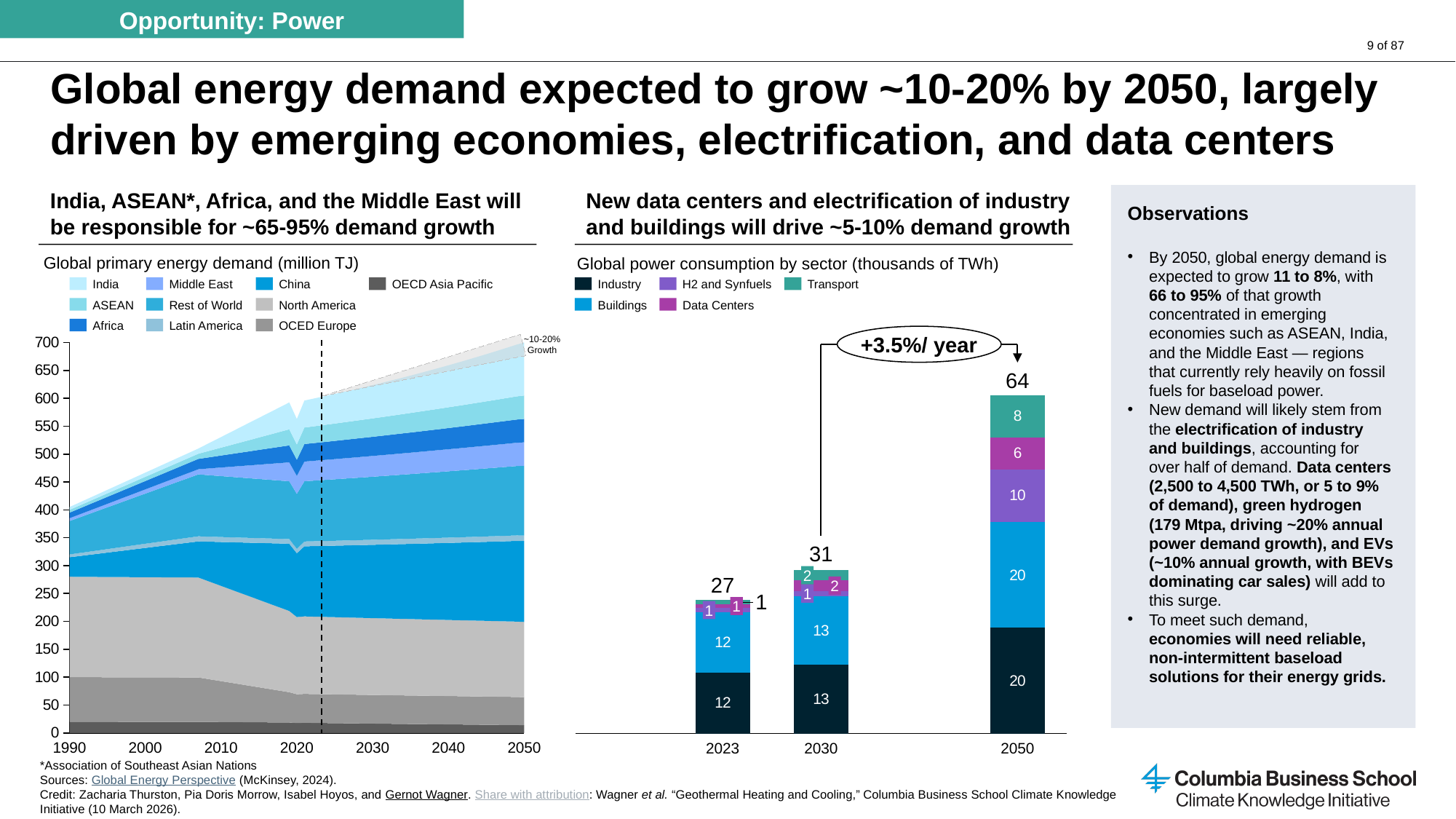
In the 'Global power consumption by sector' chart, what is the Data Centers value for 2030? 2 How many series does the legend of the 'Global power consumption by sector' chart list? 5 In the 'Global power consumption by sector' chart, what is the difference between the 2050 total and the 2023 total? 37 In the 'Global power consumption by sector' chart, what is the total value shown for 2050? 64 In the 'Global power consumption by sector' chart, which is larger in 2050: H2 and Synfuels or Data Centers? H2 and Synfuels How many series does the legend of the 'Global primary energy demand' chart list? 10 What annual growth rate is annotated on the 'Global power consumption by sector' chart? +3.5%/ year In the 'Global primary energy demand' chart, does total demand rise or fall from 1990 to 2050? Rise In the 'Global power consumption by sector' chart, what is the Transport value for 2050? 8 In the 'Global power consumption by sector' chart, what is the Industry value for 2050? 20 What kind of chart is the 'Global power consumption by sector' chart? Stacked bar chart In the 'Global power consumption by sector' chart, which year has the highest total? 2050